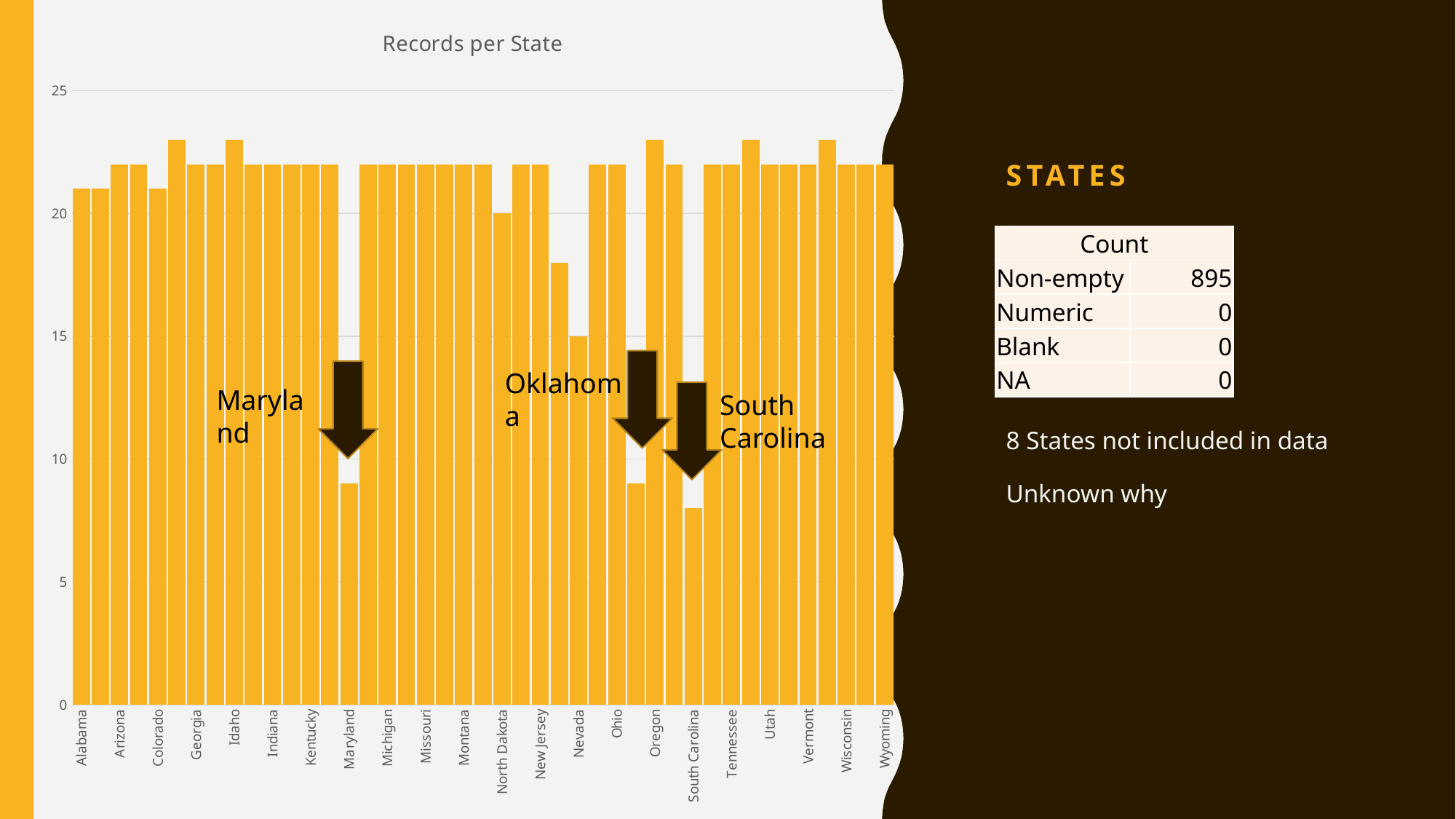
Which state has the lowest number of records? South Carolina Which has more records, Nevada or New Jersey? New Jersey Is the value for Alabama greater or less than 20? greater Is the value for New Jersey greater or less than 15? greater Is the value for Idaho greater or less than 20? greater What kind of chart is shown on the slide? bar chart Which three states are marked with arrows on the chart? Maryland, Oklahoma, South Carolina Which has more records, Maryland or Idaho? Idaho What is the title of the chart? Records per State